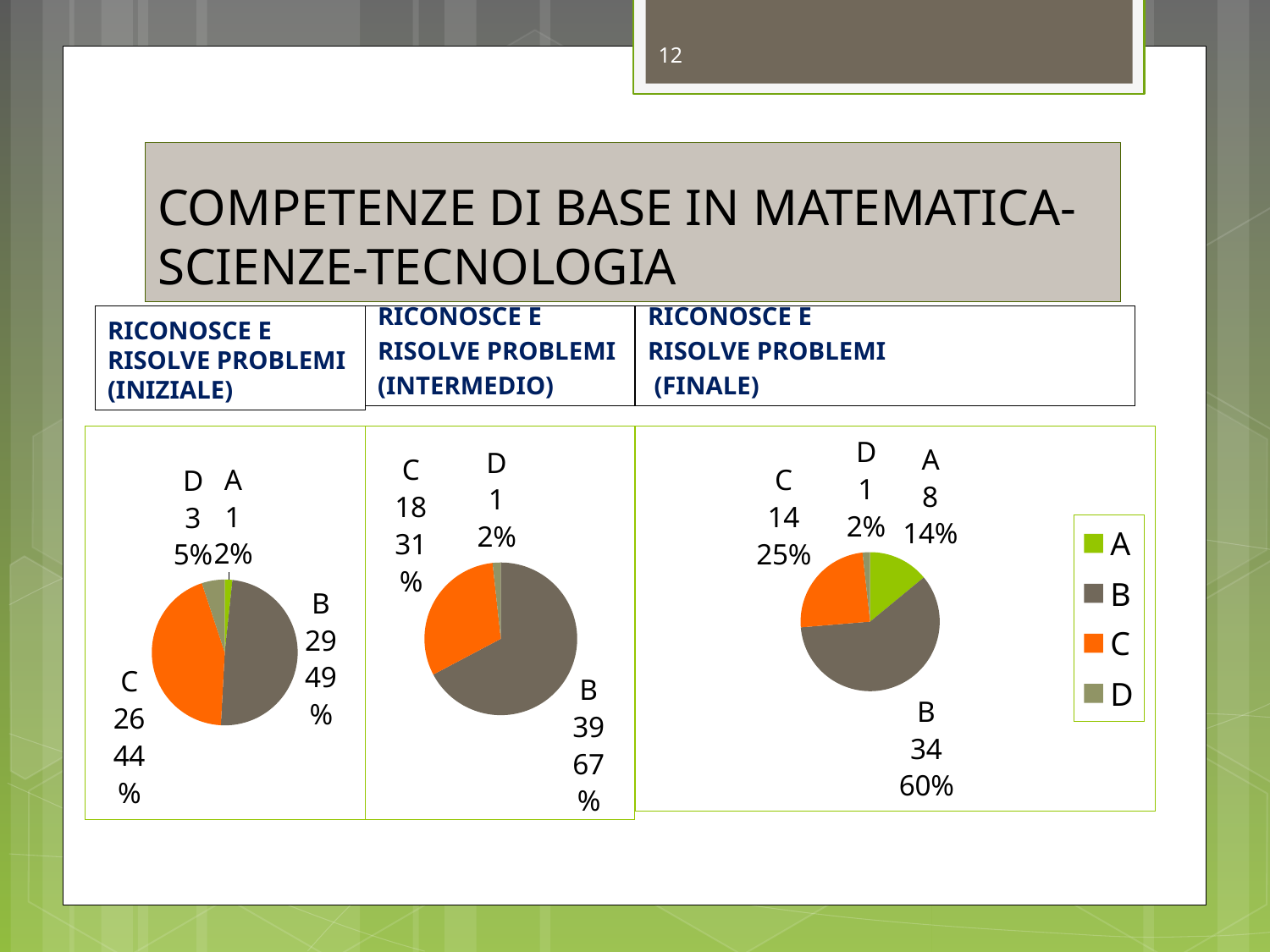
In the RICONOSCE E RISOLVE PROBLEMI (INTERMEDIO) pie chart, what percentage does slice B represent? 67% What kind of charts are shown on the slide? Pie charts In the RICONOSCE E RISOLVE PROBLEMI (INTERMEDIO) pie chart, what is the count shown for category C? 18 In the RICONOSCE E RISOLVE PROBLEMI (FINALE) pie chart, what is the count shown for category B? 34 In the RICONOSCE E RISOLVE PROBLEMI (FINALE) pie chart, which is larger, the slice for C or the slice for A? C In the RICONOSCE E RISOLVE PROBLEMI (INIZIALE) pie chart, which category has the smallest slice? A In the RICONOSCE E RISOLVE PROBLEMI (INIZIALE) pie chart, what percentage does slice B represent? 49% In the RICONOSCE E RISOLVE PROBLEMI (FINALE) pie chart, what is the difference between the counts for B and C? 20 In the RICONOSCE E RISOLVE PROBLEMI (FINALE) pie chart, what percentage does slice A represent? 14% In the RICONOSCE E RISOLVE PROBLEMI (INIZIALE) pie chart, what is the count shown for category C? 26 How many entries does the legend on the slide list? 4 In the RICONOSCE E RISOLVE PROBLEMI (INTERMEDIO) pie chart, which category has the largest slice? B